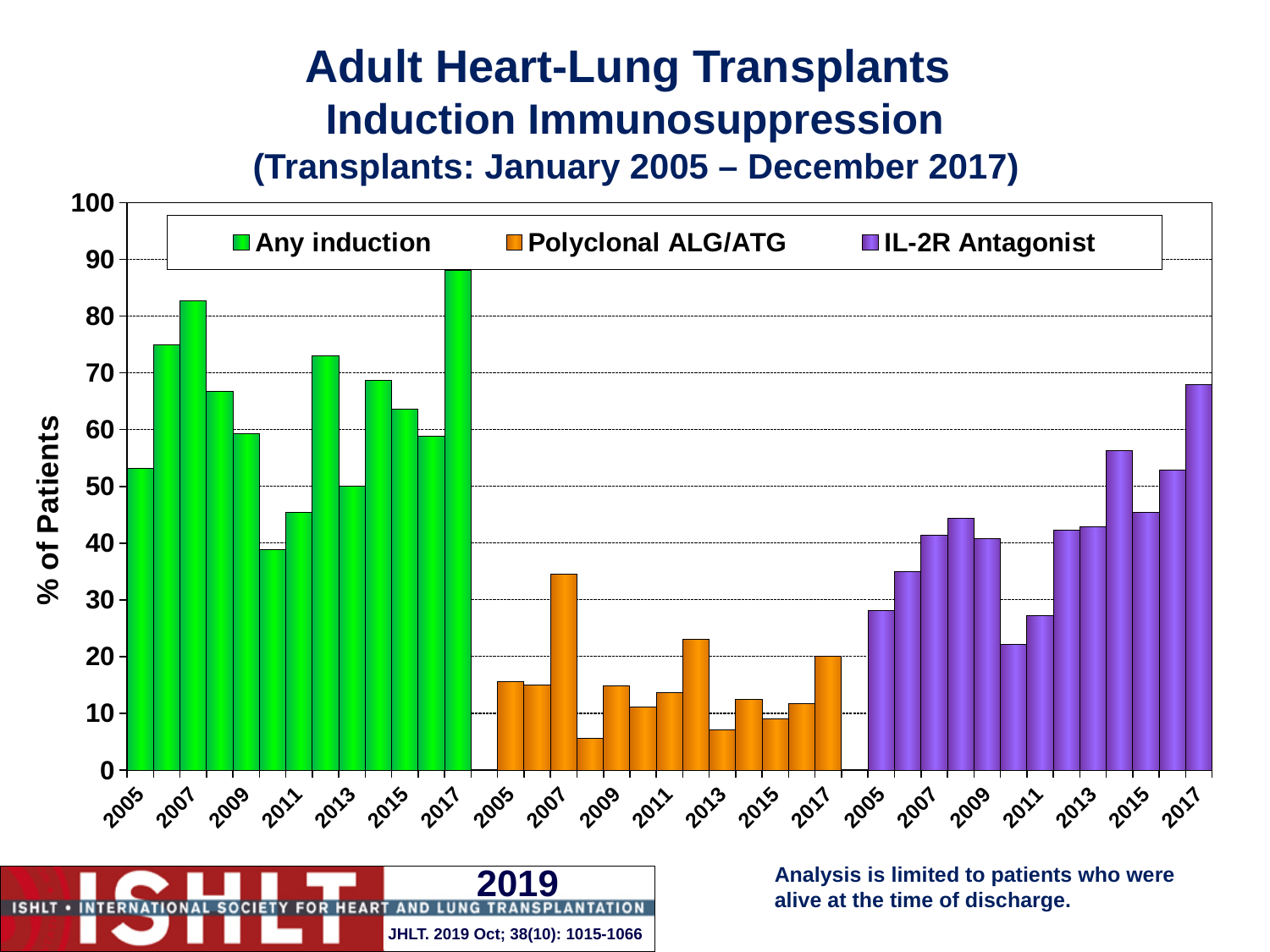
In which year is the Polyclonal ALG/ATG value lowest? 2008 What kind of chart is shown on the slide? bar chart Which is larger for Polyclonal ALG/ATG: the value for 2012 or the value for 2013? 2012 In which year is the Polyclonal ALG/ATG value highest? 2007 In which year is the IL-2R Antagonist value highest? 2017 In which year is the Any induction value highest? 2017 In which year is the IL-2R Antagonist value lowest? 2010 In which year is the Any induction value lowest? 2010 Is the Any induction value for 2007 greater or less than 80? greater How many series does the legend list? 3 What is the label on the y axis? % of Patients Is the IL-2R Antagonist value for 2005 greater or less than 30? less